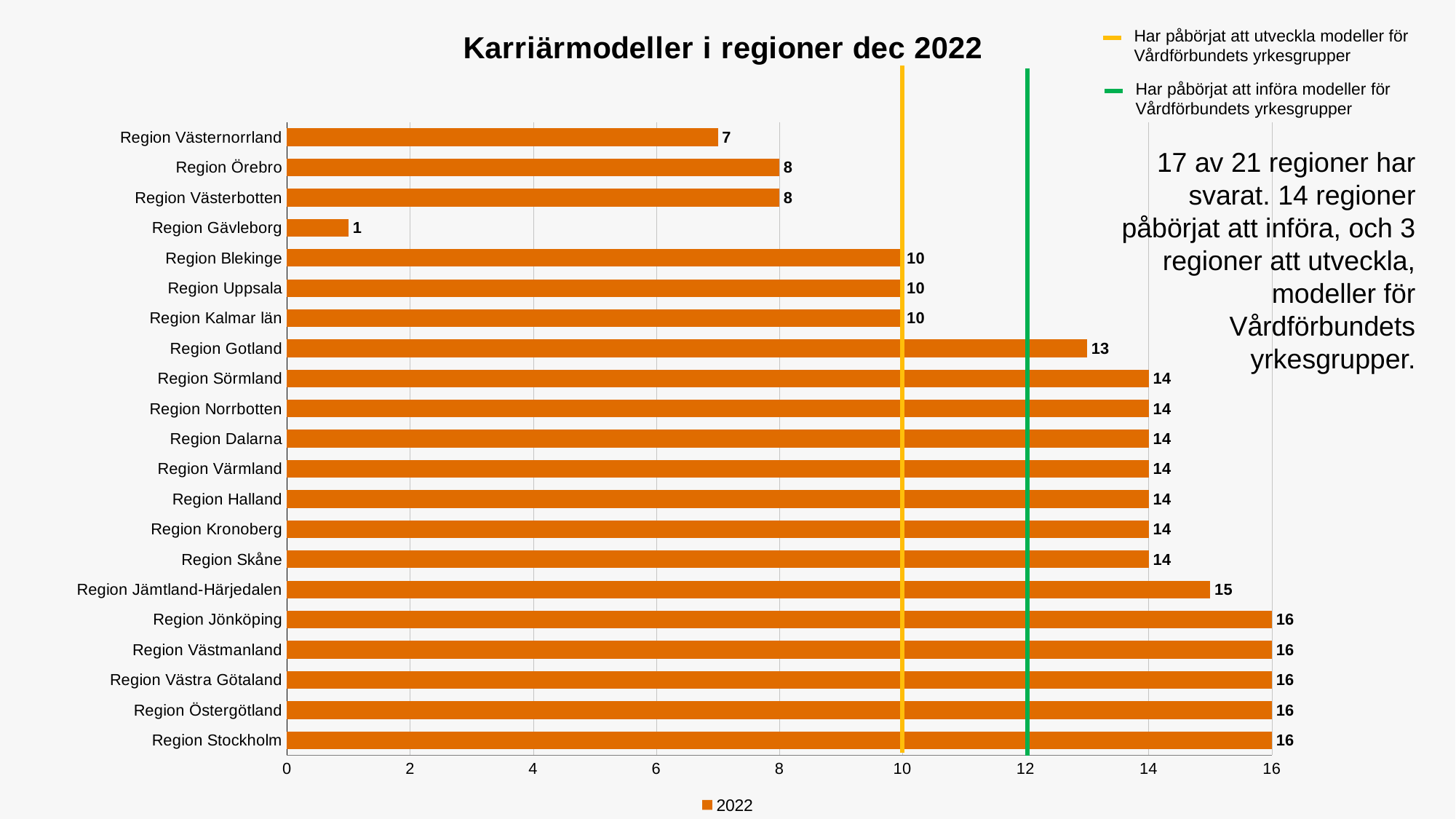
What is the value for Region Gotland? 13 How many regions are shown in the chart? 21 Which region has the lowest value? Region Gävleborg What is the value for Region Jämtland-Härjedalen? 15 What is the difference between the values for Region Stockholm and Region Gävleborg? 15 What is the value for Region Västernorrland? 7 What type of chart is shown on the slide? bar chart What is the highest value shown in the chart? 16 What is the title of the chart? Karriärmodeller i regioner dec 2022 What colour is the vertical line at the value 12? green Which has a larger value, Region Örebro or Region Blekinge? Region Blekinge How many series does the legend below the chart list? 1